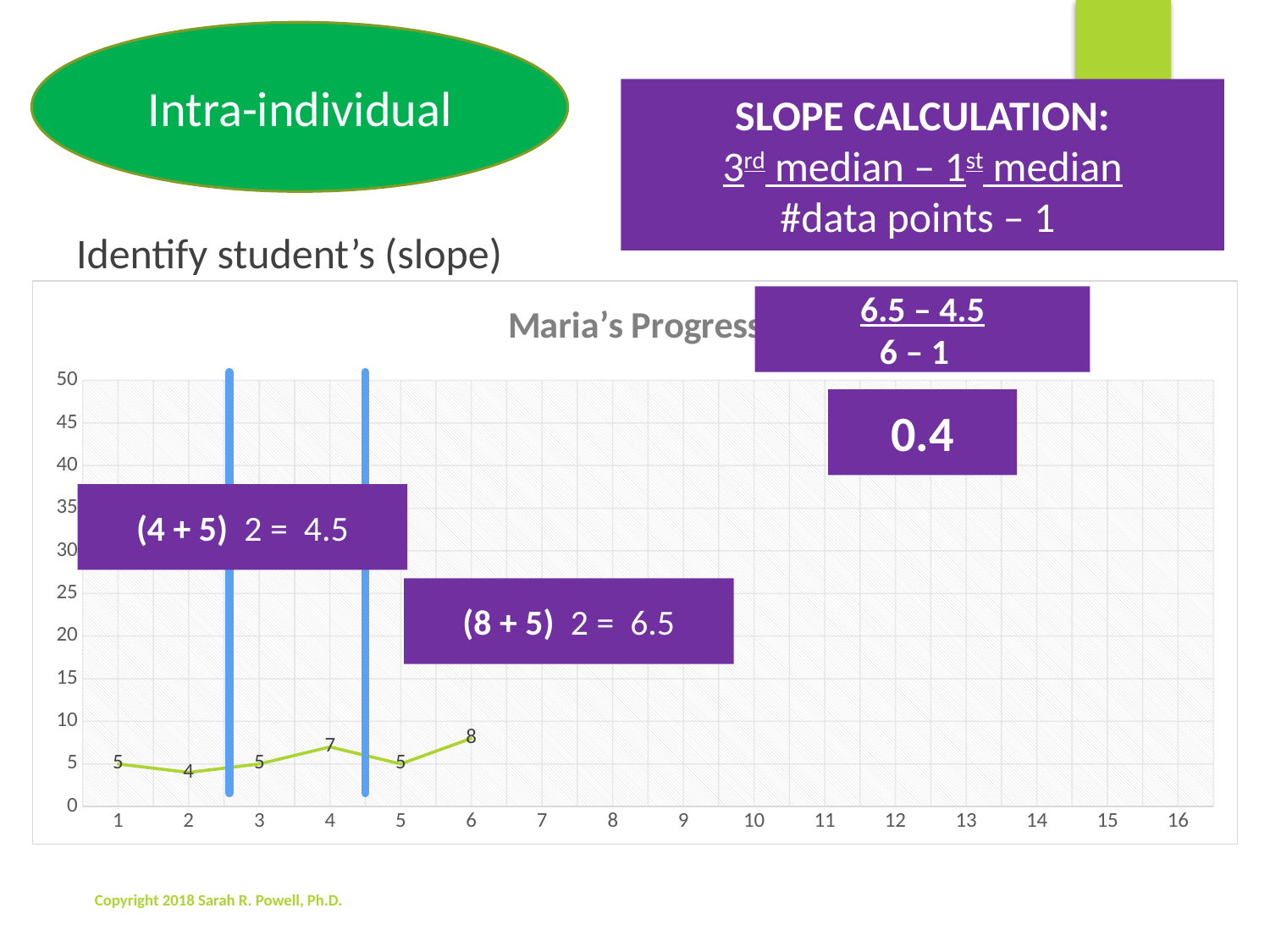
At which x value is the plotted value highest? 6 What is the value plotted at x = 1 in the Maria's Progress chart? 5 How many data points are plotted on the line? 6 What is the title of the chart? Maria's Progress What is the difference between the values at x = 6 and x = 2? 4 What is the value plotted at x = 2 in the Maria's Progress chart? 4 What type of chart is shown on the slide? line chart At which x value is the plotted value lowest? 2 Which is larger, the value at x = 4 or the value at x = 5? x = 4 What is the value plotted at x = 6 in the Maria's Progress chart? 8 Is the value at x = 6 greater or less than 10? less What is the value plotted at x = 4 in the Maria's Progress chart? 7